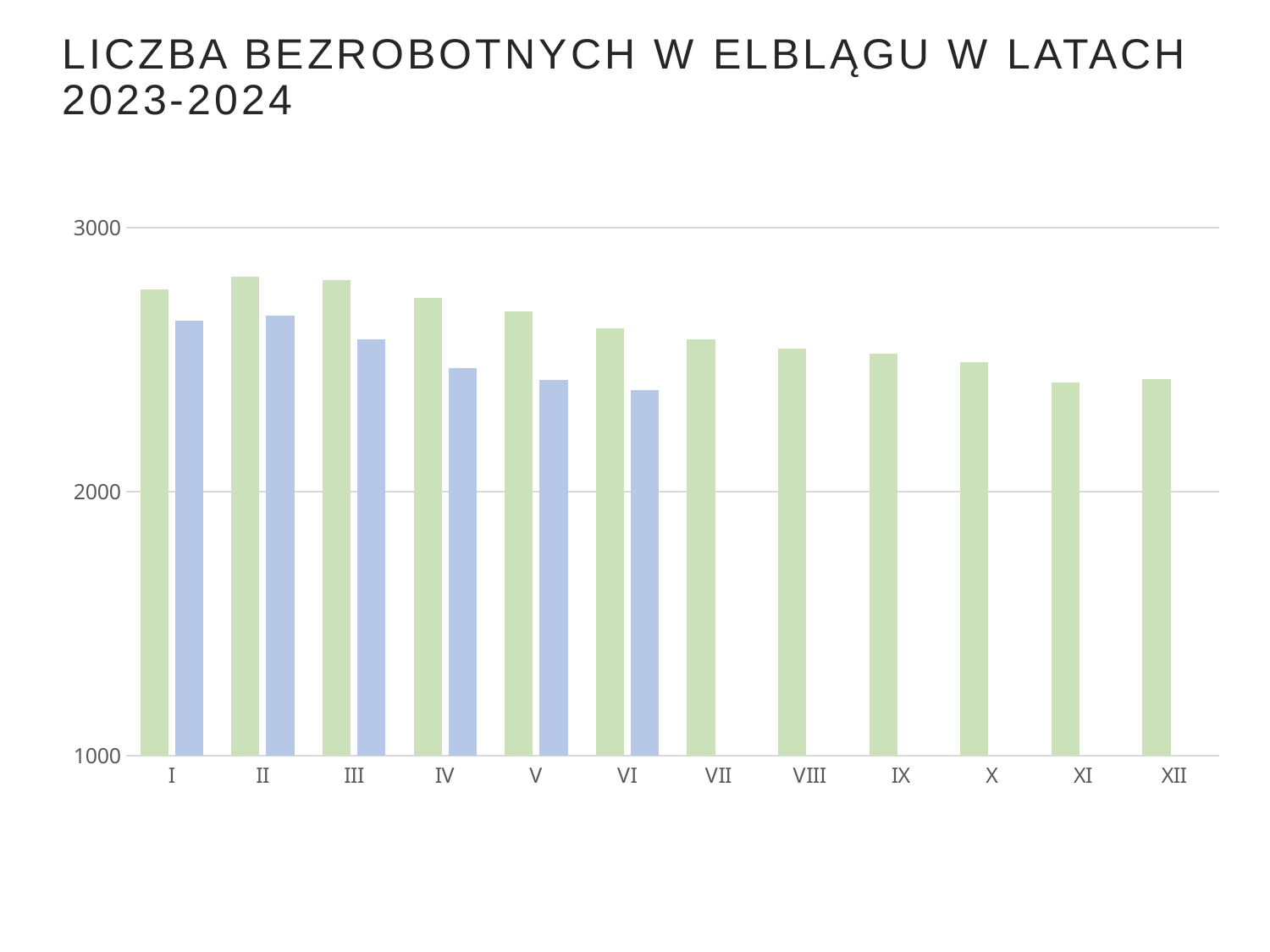
What is the title of the chart? LICZBA BEZROBOTNYCH W ELBLĄGU W LATACH 2023-2024 How many months have a blue bar? 6 Is the blue bar for month VI greater or less than 2000? greater Is the green bar for month II greater or less than 3000? less What kind of chart is shown on the slide? bar chart Do the blue bars generally rise or fall from month II to month VI? fall Is the green bar for month I greater or less than 2000? greater How many month categories are shown on the x axis? 12 Which is larger, the green bar for month I or the green bar for month XII? month I Which is larger, the blue bar for month II or the blue bar for month VI? month II For month IV, which bar is taller, the green one or the blue one? green Among the blue bars, which month has the lowest value? VI